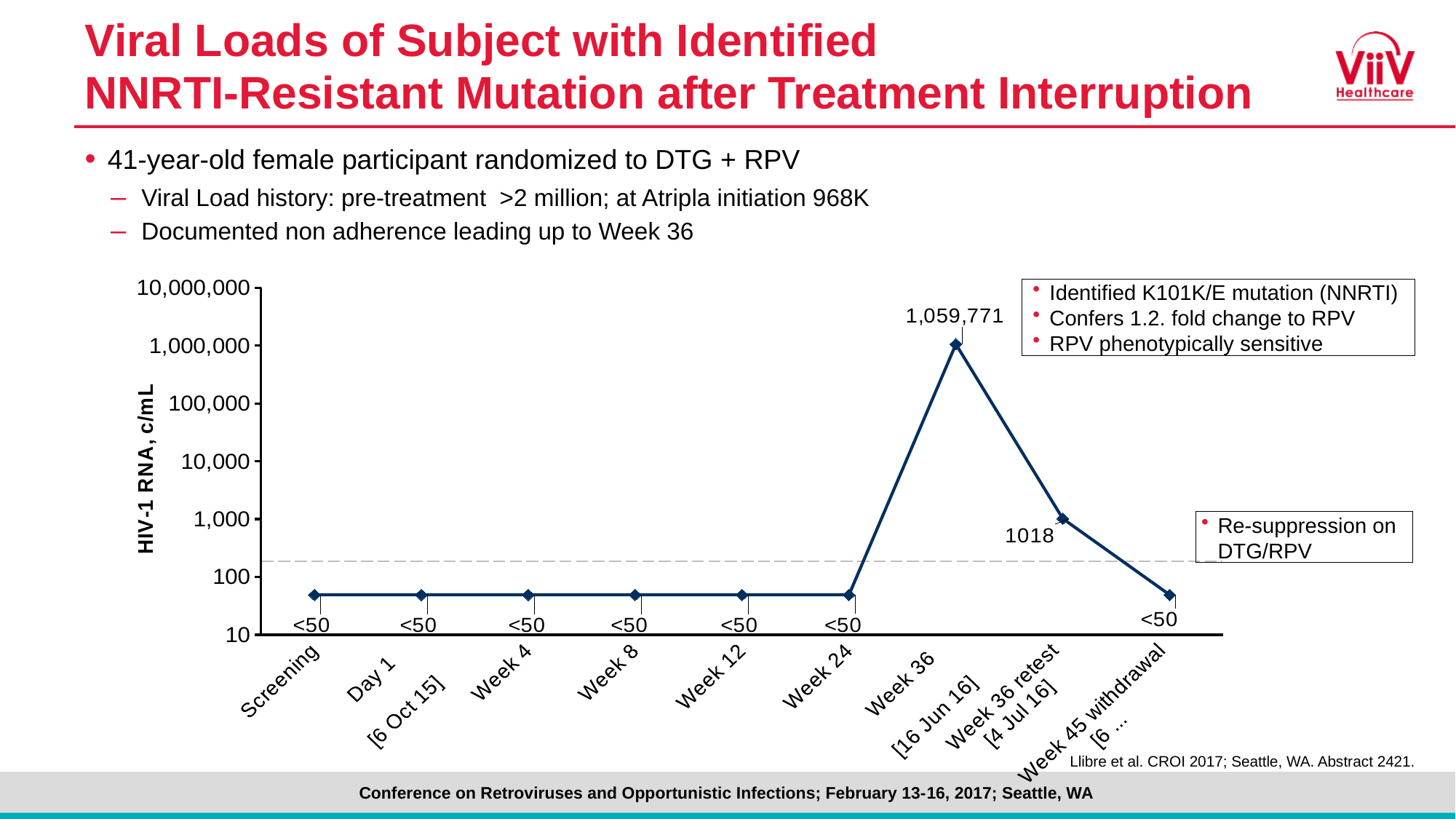
What value is shown for the Screening time point? <50 How many time points are plotted on the x axis? 9 What is the HIV-1 RNA value plotted at Week 36? 1,059,771 Which is larger, the value at Week 36 or the value at the Week 36 retest? Week 36 At which time point is the HIV-1 RNA value highest? Week 36 What value is shown at Week 45 withdrawal? <50 What is the label of the y axis? HIV-1 RNA, c/mL Is the value at Week 36 greater or less than 1,000,000? greater What kind of chart is shown on the slide? line chart What is the HIV-1 RNA value plotted at the Week 36 retest? 1018 What is the difference between the Week 36 value and the Week 36 retest value? 1,058,753 How many time points have a value labelled <50? 7